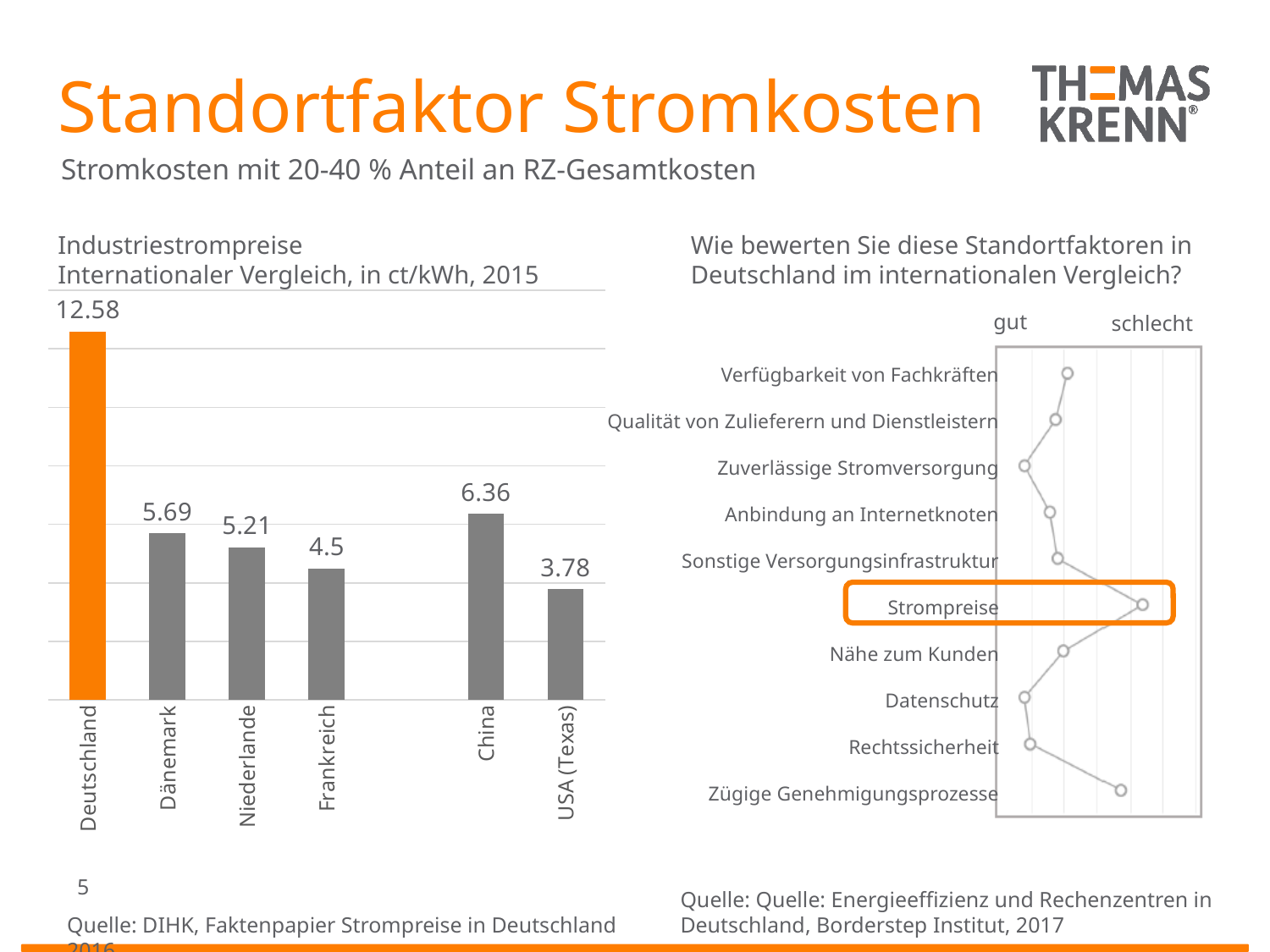
In the right chart 'Wie bewerten Sie diese Standortfaktoren in Deutschland im internationalen Vergleich?', which factor is rated furthest toward 'schlecht'? Strompreise In the bar chart 'Industriestrompreise Internationaler Vergleich', what is the value for China? 6.36 In the bar chart 'Industriestrompreise Internationaler Vergleich', what unit are the values given in? ct/kWh In the bar chart 'Industriestrompreise Internationaler Vergleich', what is the difference between the values for Deutschland and Dänemark? 6.89 In the bar chart 'Industriestrompreise Internationaler Vergleich', which country has the lowest value? USA (Texas) What kind of chart is the left chart 'Industriestrompreise Internationaler Vergleich'? Bar chart In the bar chart 'Industriestrompreise Internationaler Vergleich', what is the value for USA (Texas)? 3.78 In the bar chart 'Industriestrompreise Internationaler Vergleich', which is larger, the value for Niederlande or the value for Frankreich? Niederlande In the bar chart 'Industriestrompreise Internationaler Vergleich', what is the value for Deutschland? 12.58 In the bar chart 'Industriestrompreise Internationaler Vergleich', which country has the highest value? Deutschland In the right chart 'Wie bewerten Sie diese Standortfaktoren in Deutschland im internationalen Vergleich?', how many factors are listed? 10 In the bar chart 'Industriestrompreise Internationaler Vergleich', how many countries are shown? 6